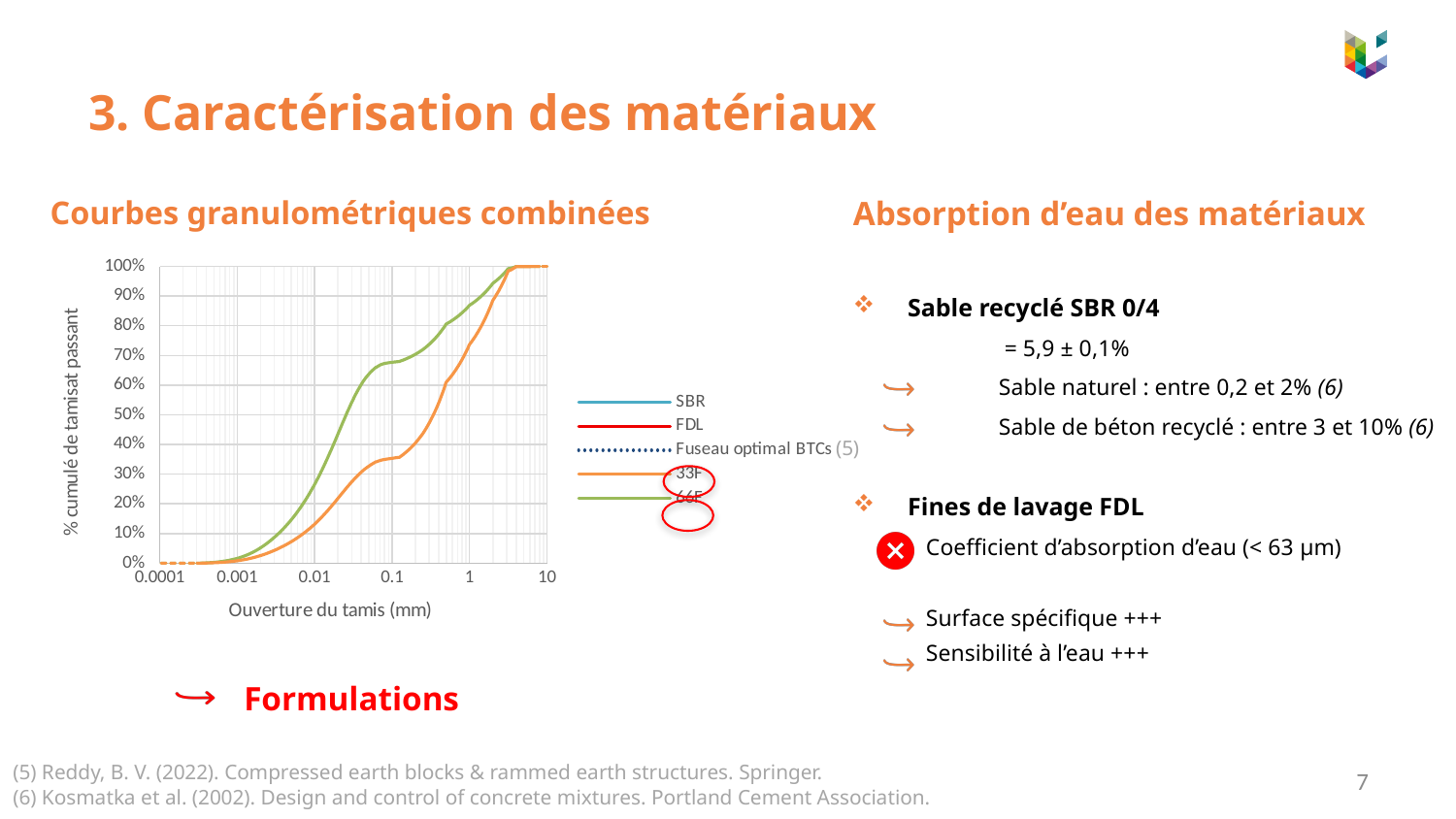
In the granulometric chart, which curve is higher at a sieve opening of 0.1 mm, 33F or 66F? 66F What is the title of the x axis of the granulometric chart? Ouverture du tamis (mm) In the granulometric chart, is the value of the 66F curve at 0.1 mm greater or less than 60%? greater In the granulometric chart, is the value of the 33F curve at 0.01 mm greater or less than 20%? less What kind of chart is shown under 'Courbes granulométriques combinées'? line chart In the granulometric chart, is the value of the 33F curve at 0.1 mm greater or less than 50%? less How many series does the legend of the granulometric chart list? 5 Do the curves in the granulometric chart rise or fall as the sieve opening increases? rise What is the title of the y axis of the granulometric chart? % cumulé de tamisat passant What value do the curves in the granulometric chart reach at a sieve opening of 10 mm? 100% What is the highest value shown on the y axis of the granulometric chart? 100%